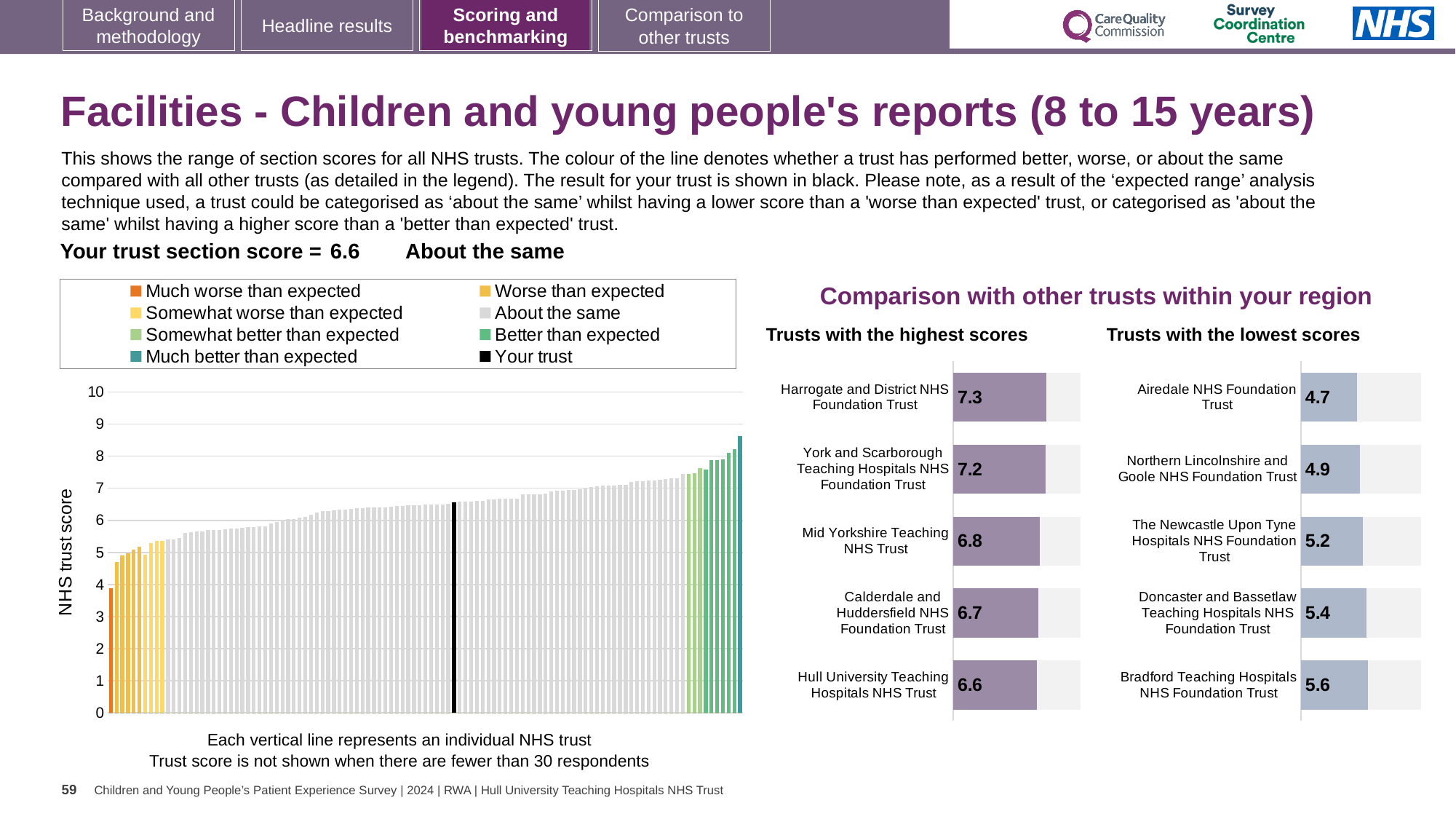
In the main chart on the left showing the range of NHS trust scores, what is the section score for your trust (the black bar)? 6.6 In the 'Trusts with the lowest scores' chart, which trust has the lowest score? Airedale NHS Foundation Trust In the 'Trusts with the highest scores' chart, what is the score for Harrogate and District NHS Foundation Trust? 7.3 In the 'Trusts with the highest scores' chart, what is the difference between the scores of Harrogate and District NHS Foundation Trust and Hull University Teaching Hospitals NHS Trust? 0.7 In the 'Trusts with the highest scores' chart, which trust has the lowest score shown? Hull University Teaching Hospitals NHS Trust In the 'Trusts with the lowest scores' chart, what is the score for The Newcastle Upon Tyne Hospitals NHS Foundation Trust? 5.2 In the 'Trusts with the lowest scores' chart, which trust has the highest score shown? Bradford Teaching Hospitals NHS Foundation Trust How many trusts are shown in the 'Trusts with the highest scores' chart? 5 How many entries does the legend of the main chart on the left list? 8 Which has a higher score: Mid Yorkshire Teaching NHS Trust in the highest scores chart or Doncaster and Bassetlaw Teaching Hospitals NHS Foundation Trust in the lowest scores chart? Mid Yorkshire Teaching NHS Trust In the 'Trusts with the lowest scores' chart, what is the difference between the scores of Bradford Teaching Hospitals NHS Foundation Trust and Airedale NHS Foundation Trust? 0.9 In the main chart on the left, is the value of the tallest bar greater or less than 8? greater